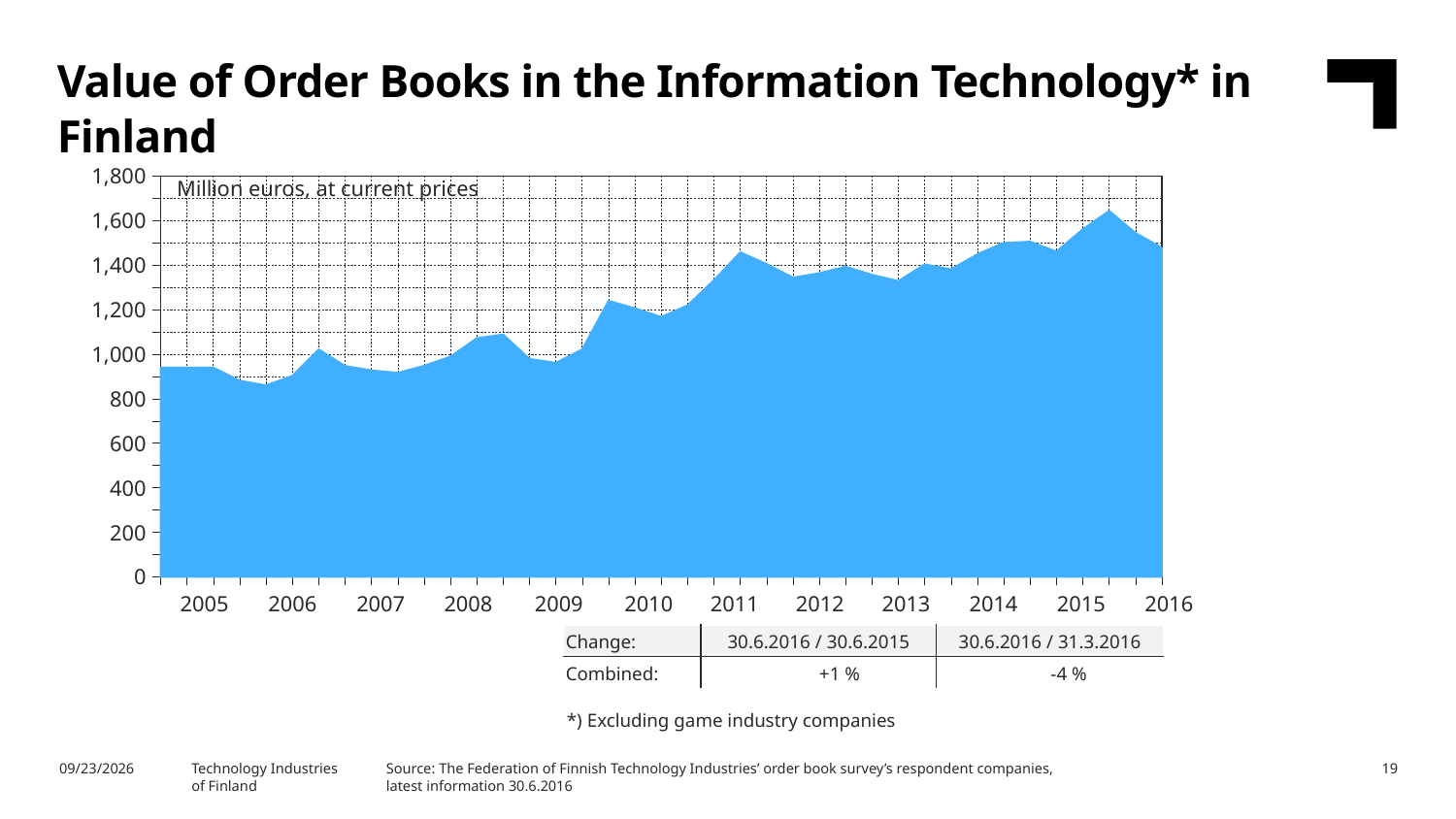
What unit is the value of order books measured in, according to the label inside the chart? Million euros, at current prices In which year does the value of order books reach its highest point? 2015 Is the peak value of order books in 2015 greater or less than 1,600? greater Which is larger: the value of order books at the start of 2005 or at the end of 2016? End of 2016 Is the value of order books in 2013 greater or less than 1,200? greater Overall, does the value of order books rise or fall from 2005 to 2016? Rise How many year labels are shown on the x axis of the chart? 12 What kind of chart is shown on the slide? Area chart Is the value of order books at the start of 2005 greater or less than 1,000? less What is the combined change in order books for 30.6.2016 compared with 30.6.2015, as shown in the table below the chart? +1 %